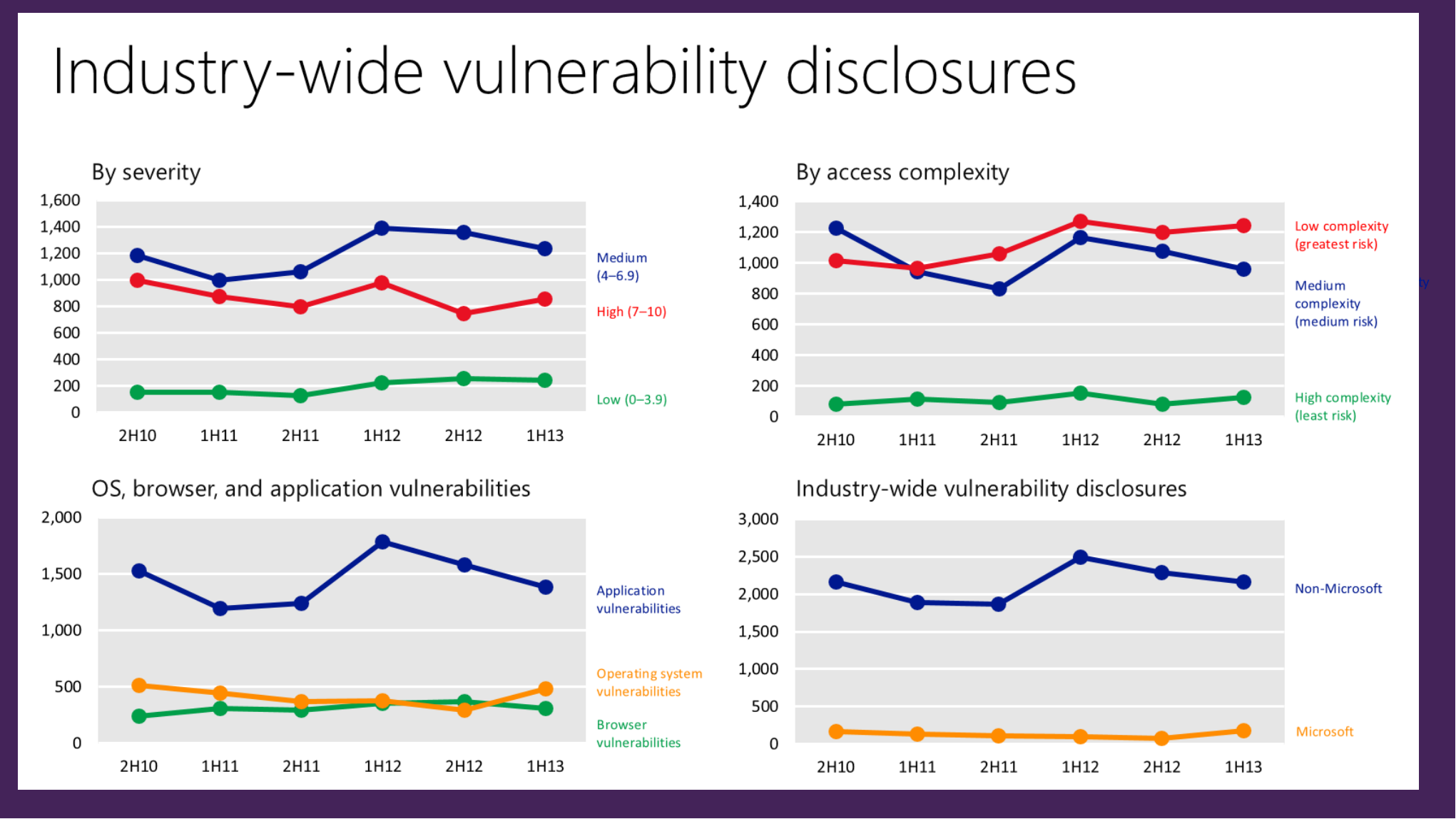
In the "By access complexity" chart, which series has the highest value at 1H13? Low complexity (greatest risk) In the "By severity" chart, which series has the lowest value at 2H12? Low (0–3.9) In the "OS, browser, and application vulnerabilities" chart, which series has the highest value at 1H12? Application vulnerabilities In the "OS, browser, and application vulnerabilities" chart, is the value for Application vulnerabilities at 1H12 greater or less than 1,500? greater In the "By access complexity" chart, is the value for High complexity (least risk) at 2H12 greater or less than 200? less In the "By severity" chart, does the Medium (4–6.9) series rise or fall from 2H11 to 1H12? rise In the "Industry-wide vulnerability disclosures" chart, in which period is the Non-Microsoft series at its highest? 1H12 In the "By severity" chart, how many time periods are shown on the x axis? 6 In the "Industry-wide vulnerability disclosures" chart, is the Non-Microsoft value at 1H12 greater or less than 2,000? greater How many series are plotted in the "By access complexity" chart? 3 What kind of chart is the "By severity" chart? line chart